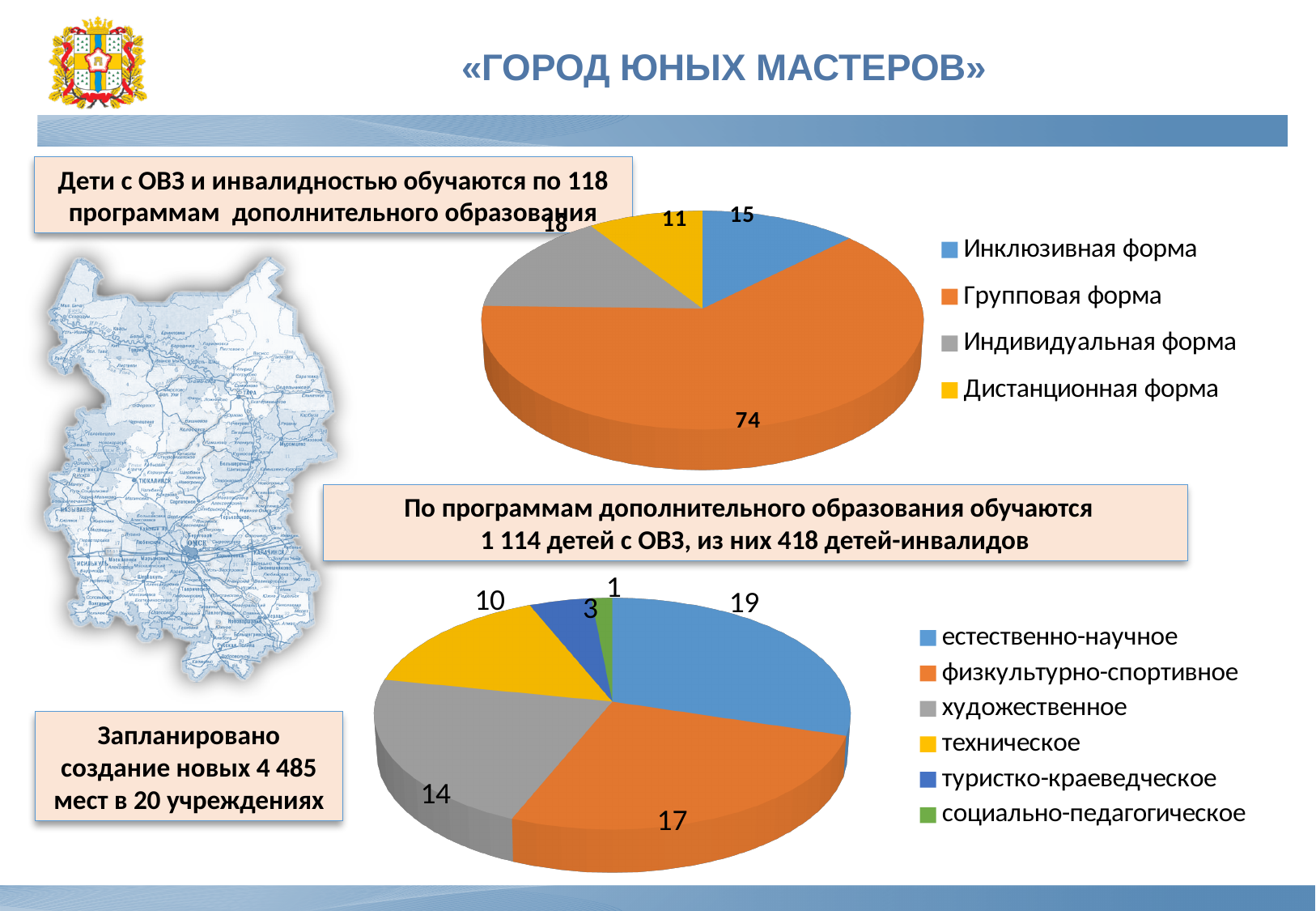
In the top pie chart, what is the value for Групповая форма? 74 How many categories does the legend of the bottom pie chart list? 6 In the bottom pie chart, which category has the largest value? естественно-научное What type of chart is the top chart on the slide? Pie chart In the bottom pie chart, which is larger: техническое or туристко-краеведческое? техническое In the top pie chart, which category has the smallest value? Дистанционная форма In the top pie chart, what is the value for Дистанционная форма? 11 In the bottom pie chart, which category has the smallest value? социально-педагогическое In the top pie chart, which category has the largest value? Групповая форма In the top pie chart, what is the difference between Индивидуальная форма and Инклюзивная форма? 3 In the bottom pie chart, what is the value for художественное? 14 How many categories does the legend of the top pie chart list? 4